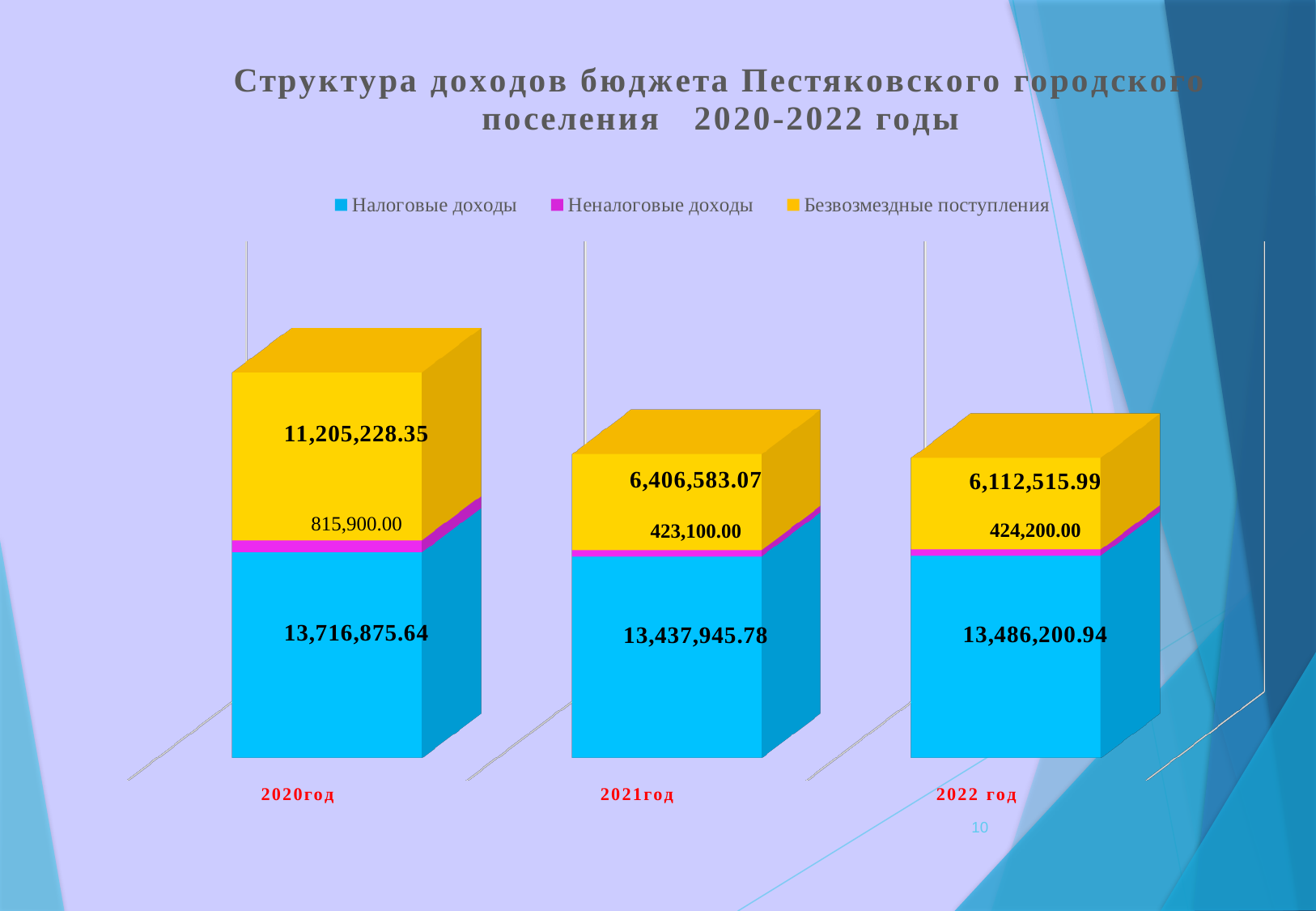
How many years are shown on the x axis? 3 In which year is Безвозмездные поступления the highest? 2020год What is the value of Налоговые доходы for 2020год? 13,716,875.64 What is the total of the stacked bar for 2021год? 20,267,628.85 What kind of chart is shown on the slide? Stacked bar chart What is the difference between Безвозмездные поступления in 2020год and 2021год? 4,798,645.28 In which year is Налоговые доходы the lowest? 2021год Do the values of Безвозмездные поступления rise or fall from 2020год to 2022 год? Fall What is the value of Неналоговые доходы for 2022 год? 424,200.00 Which is larger: Неналоговые доходы in 2021год or in 2022 год? 2022 год How many series does the legend list? 3 What is the value of Безвозмездные поступления for 2021год? 6,406,583.07